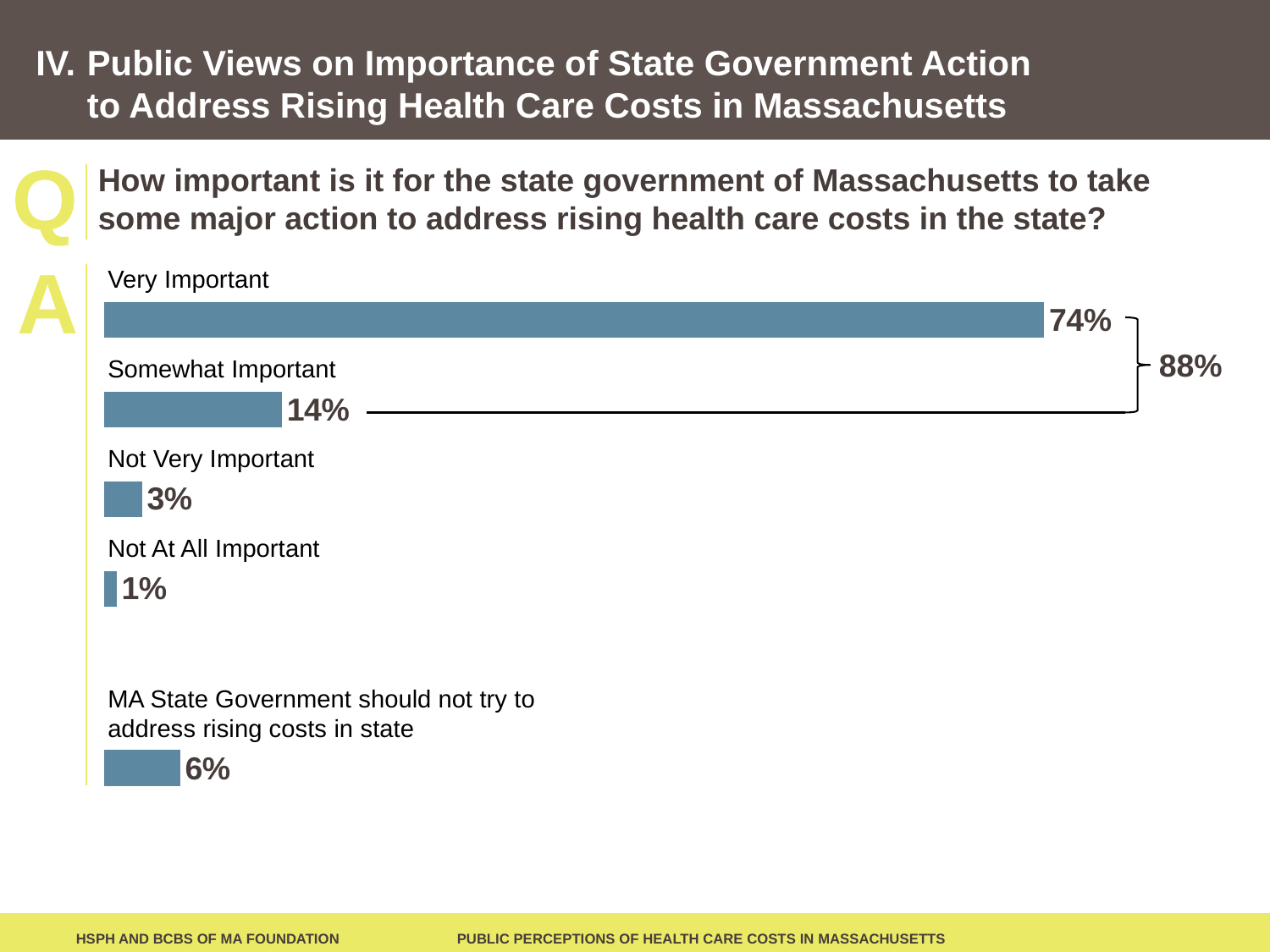
How many response categories are shown in the chart? 5 What type of chart is shown on the slide? Bar chart What percentage of respondents said Not Very Important? 3% What percentage of respondents said the MA State Government should not try to address rising costs in the state? 6% What combined percentage is shown by the bracket grouping Very Important and Somewhat Important? 88% Which response category has the highest percentage? Very Important What percentage of respondents said it is Very Important for the state government to take major action on rising health care costs? 74% Which is larger: the percentage for Not Very Important or the percentage for MA State Government should not try to address rising costs in state? MA State Government should not try to address rising costs in state What percentage of respondents said Not At All Important? 1% What percentage of respondents said Somewhat Important? 14% What is the difference in percentage points between Very Important and Somewhat Important? 60 Which response category has the lowest percentage? Not At All Important